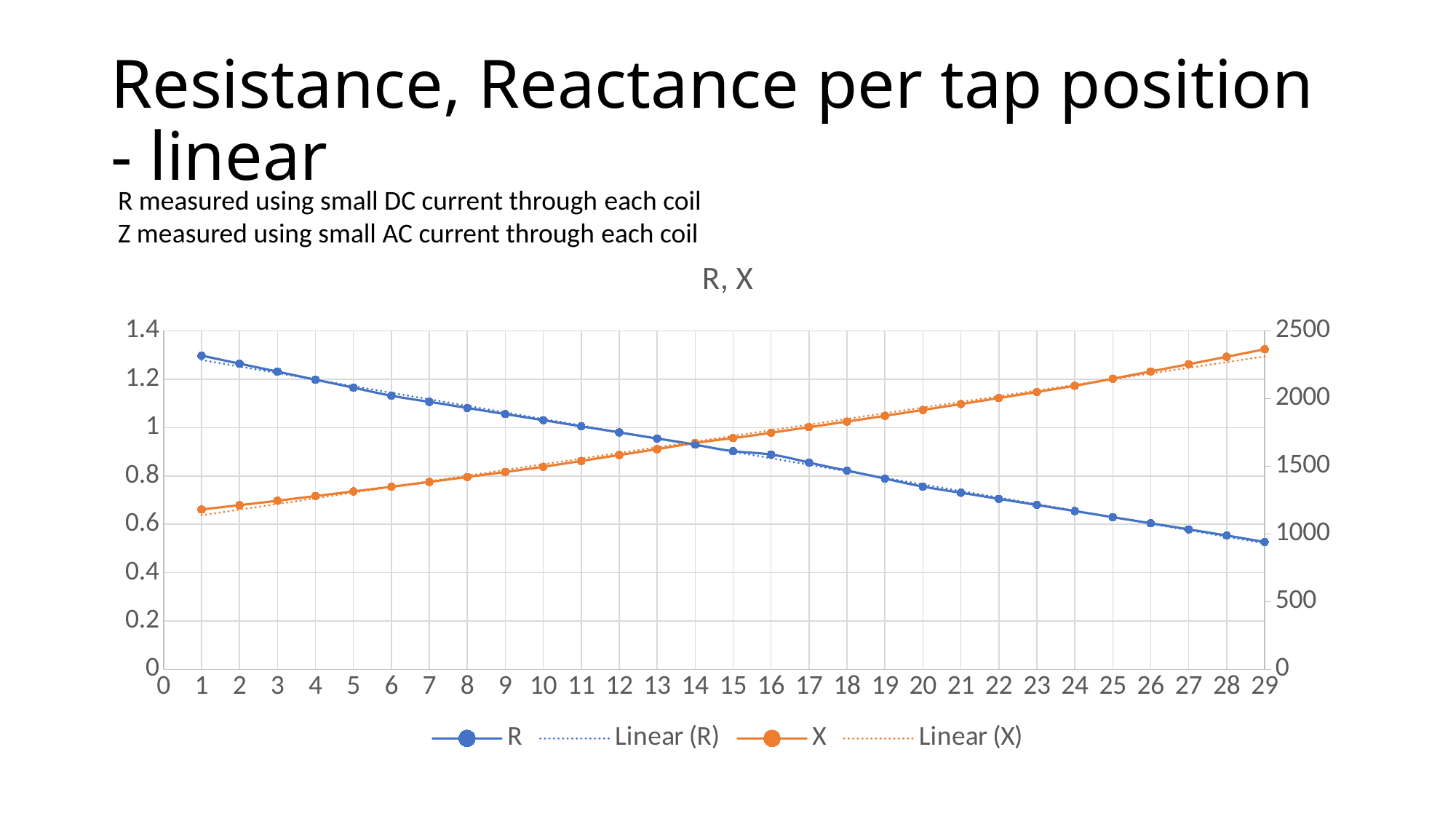
Does the X series rise or fall as the tap position increases? rises At which tap position is the R series lowest? 29 How many entries does the chart legend list? 4 What is the title of the chart? R, X At which tap position is the X series highest? 29 Is the R value at tap position 1 greater or less than 1.2 on the left axis? greater What kind of chart is shown on the slide? line chart Does the R series rise or fall as the tap position increases? falls Is the X value at tap position 29 greater or less than 2000 on the right axis? greater At which tap position is the R series highest? 1 How many tap positions have data points plotted for the R series? 29 Is the R value at tap position 29 greater or less than 0.6 on the left axis? less